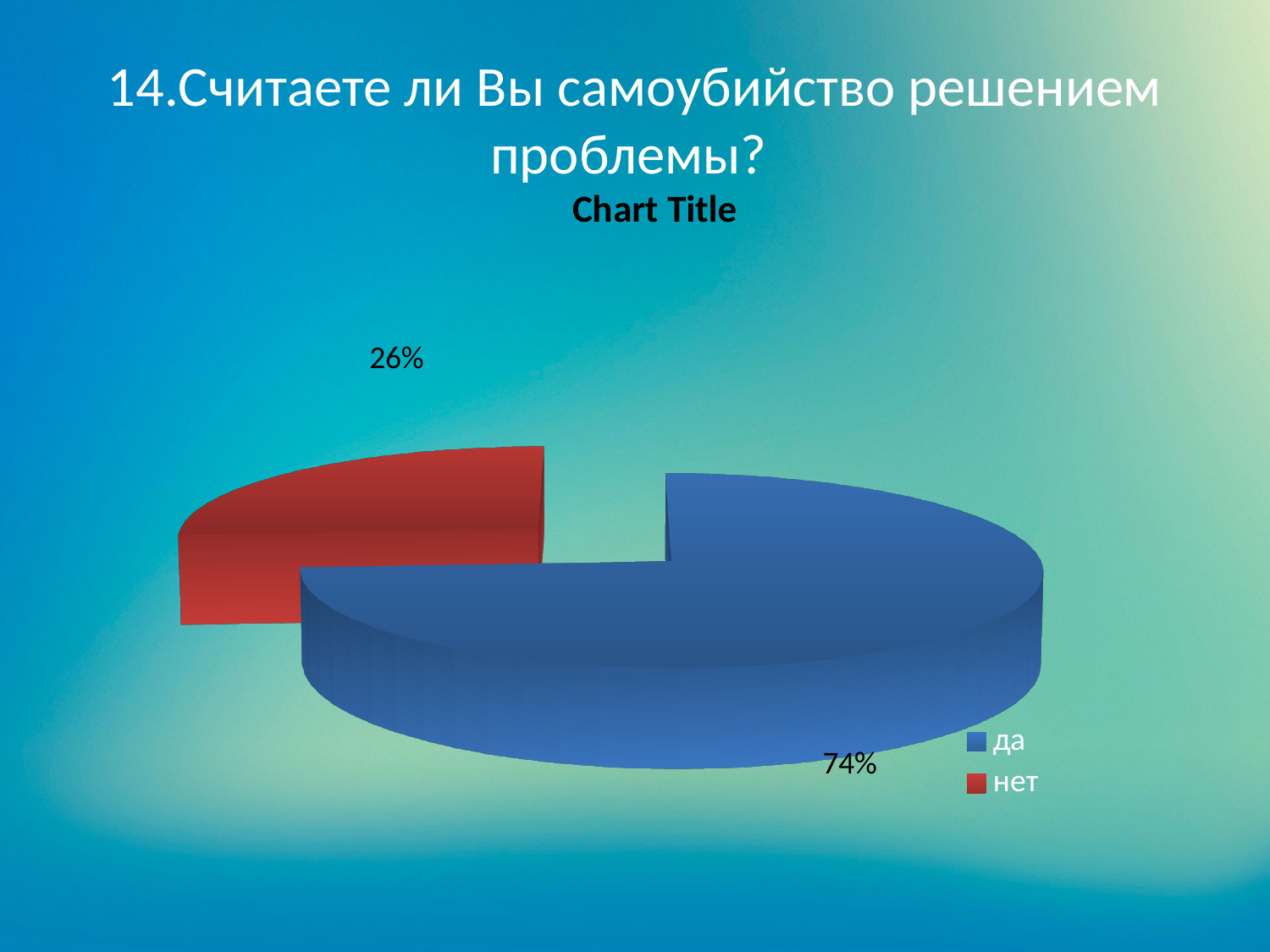
What kind of chart is shown on the slide? pie chart Which category has the smallest slice of the pie? нет What is the title shown directly above the pie chart? Chart Title What share of the pie does "да" have? 74% How many entries does the legend list? 2 What is the difference in percentage points between "да" and "нет"? 48 What share of the pie does "нет" have? 26% What colour is the slice for "нет"? red How many categories does the pie chart have? 2 Which is larger, the share for "да" or the share for "нет"? да Which category has the largest slice of the pie? да